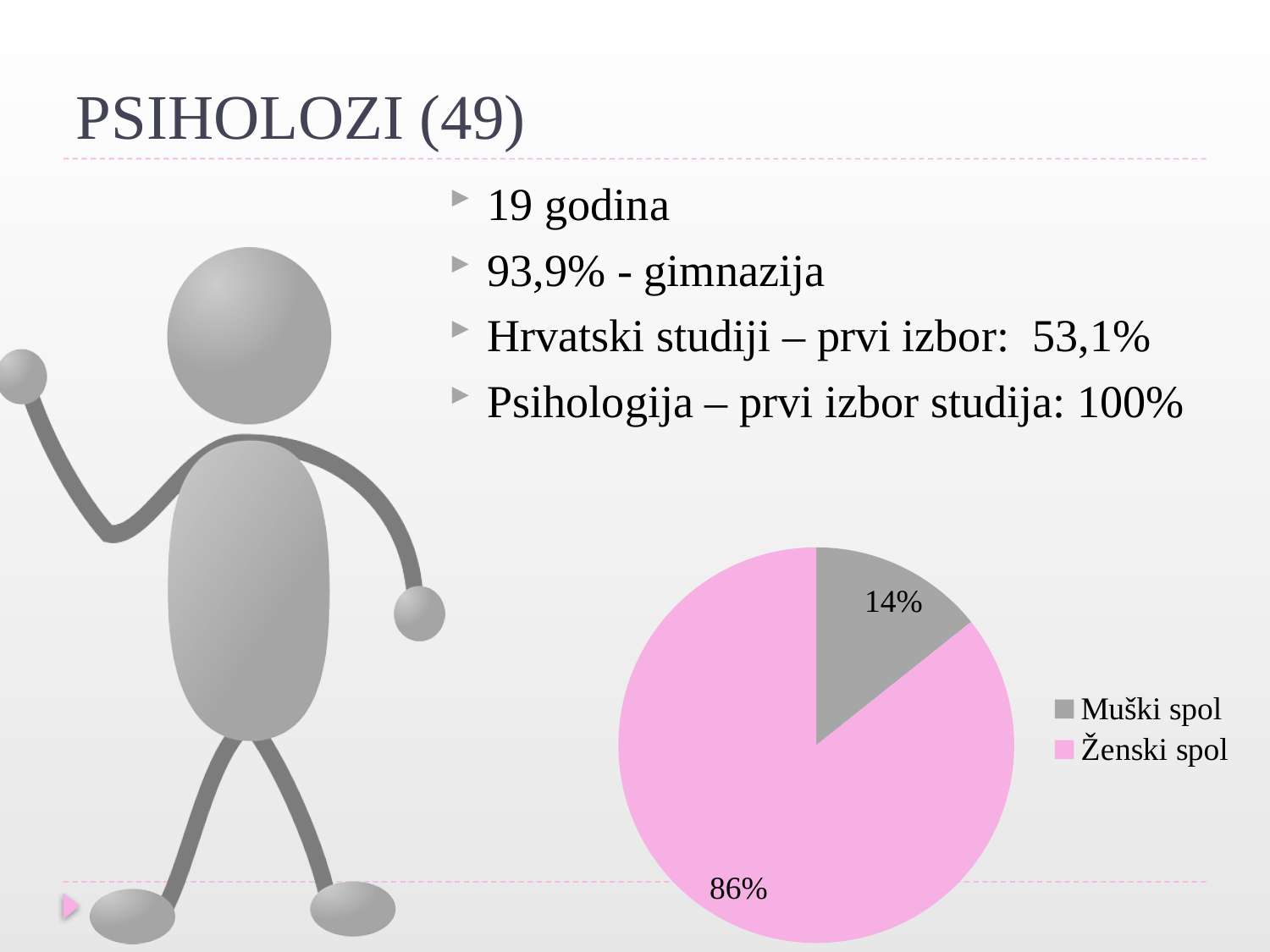
What is the difference in percentage points between the Ženski spol and Muški spol slices? 72 Which is larger in the pie chart, Muški spol or Ženski spol? Ženski spol How many categories does the pie chart show? 2 Which category has the largest slice in the pie chart? Ženski spol What colour is the Ženski spol slice in the pie chart? pink What colour is the Muški spol slice in the pie chart? grey What share of the pie chart is Muški spol? 14% What kind of chart is shown on the slide? pie chart What share of the pie chart is Ženski spol? 86% How many entries does the legend of the pie chart list? 2 Which category has the smallest slice in the pie chart? Muški spol